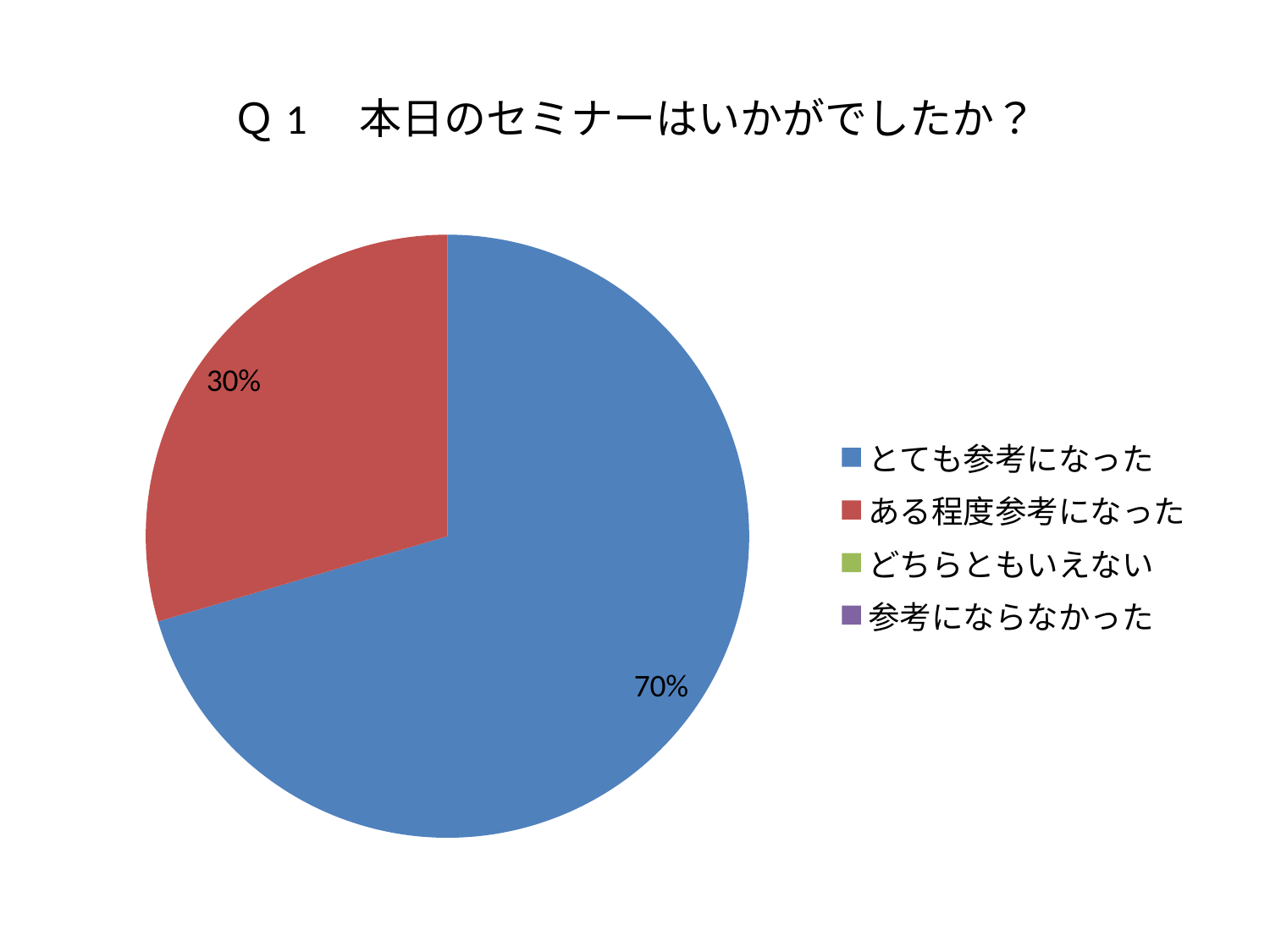
What is the difference in percentage points between the とても参考になった slice and the ある程度参考になった slice? 40 percentage points What share of the pie does とても参考になった take? 70% What share of the pie does ある程度参考になった take? 30% Which category has the largest slice of the pie? とても参考になった How many entries does the legend list? 4 Is the share for とても参考になった greater or less than 50%? greater Which is larger, the slice for とても参考になった or the slice for ある程度参考になった? とても参考になった What is the title of the chart? Q１ 本日のセミナーはいかがでしたか？ What colour is the slice for ある程度参考になった? Red How many slices are visible in the pie? 2 What kind of chart is shown on the slide? Pie chart